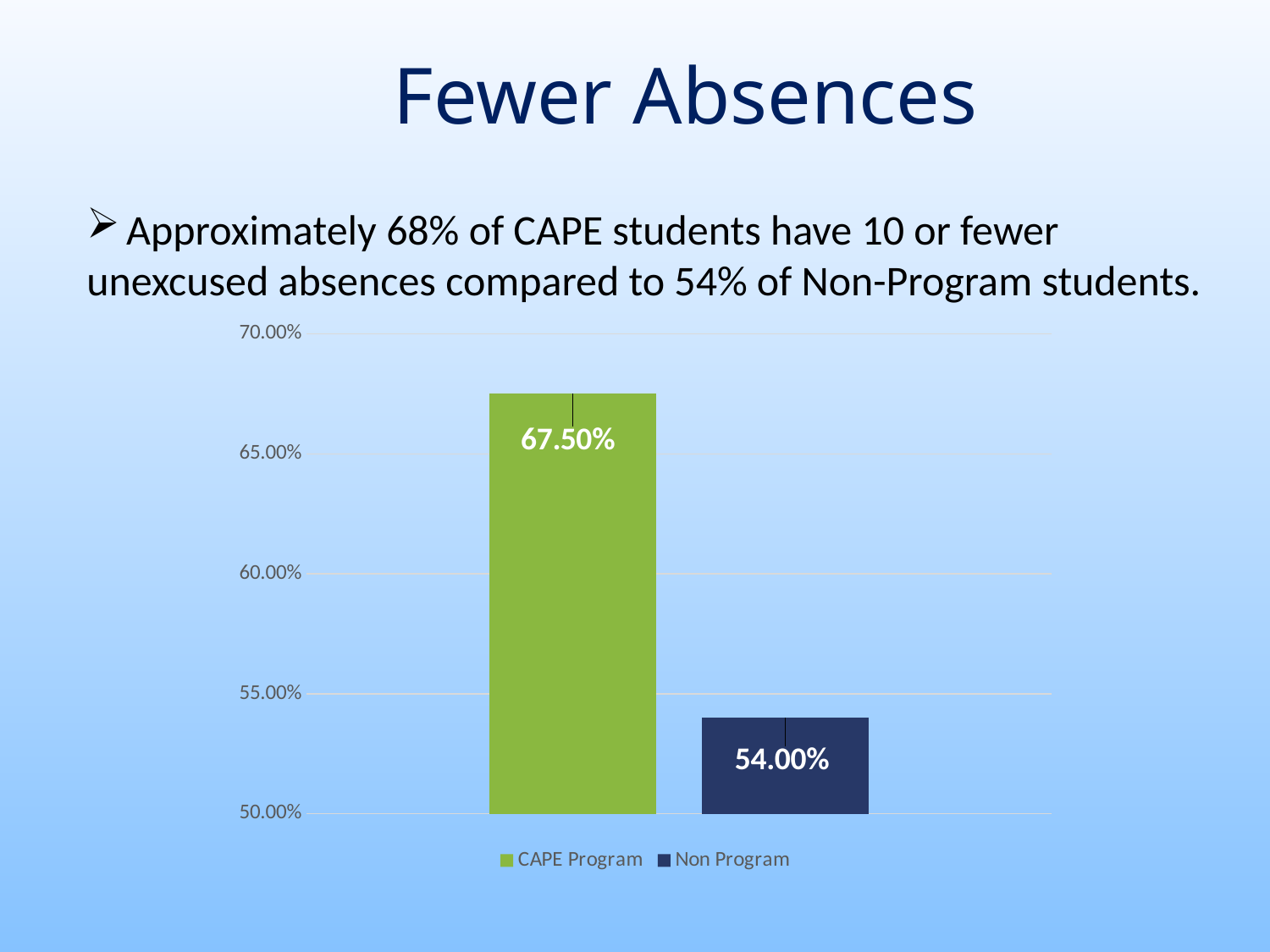
How many bars are plotted in the chart? 2 Which is larger, the value for CAPE Program or the value for Non Program? CAPE Program Which series has the highest value? CAPE Program What is the value for Non Program? 54.00% What is the value for CAPE Program? 67.50% What kind of chart is shown on the slide? bar chart Is the value for CAPE Program greater or less than 65.00%? greater How many series does the legend list? 2 Is the value for Non Program greater or less than 55.00%? less Which series has the lowest value? Non Program What is the difference between the CAPE Program and Non Program values? 13.50% What colour is the CAPE Program bar? green